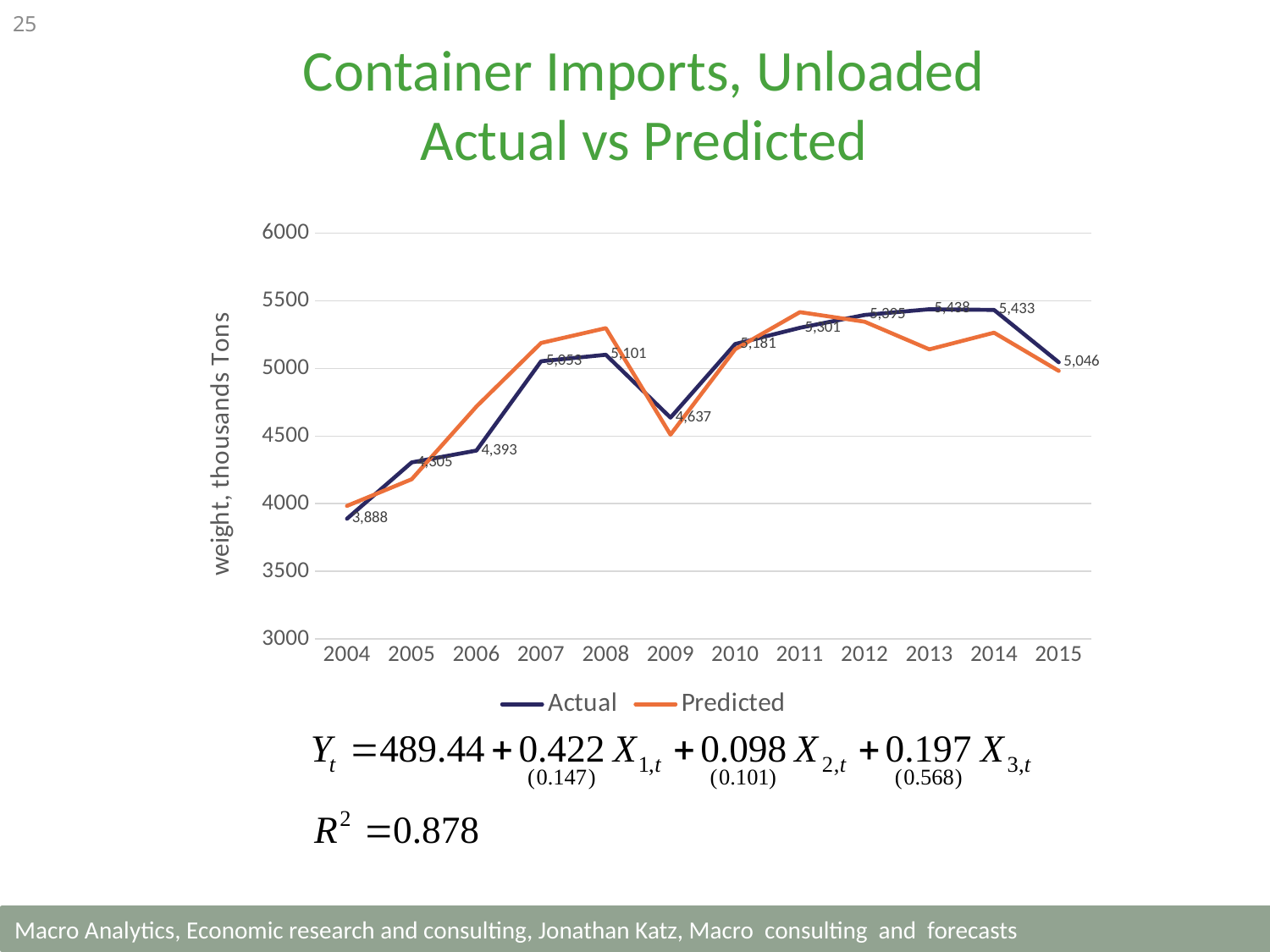
In which year is the Actual series lowest? 2004 How many years are shown on the x axis? 12 What is the Actual value for 2015? 5,046 In 2008, which series has the larger value, Actual or Predicted? Predicted What is the difference between the Actual values for 2014 and 2015? 387 What type of chart is shown on the slide? Line chart What is the difference between the Actual values for 2010 and 2009? 544 What is the label on the y axis? weight, thousands Tons Is the Predicted value for 2011 greater or less than 5000? greater How many series does the legend list? 2 What is the Actual value for 2009? 4,637 What is the Actual value for 2004? 3,888